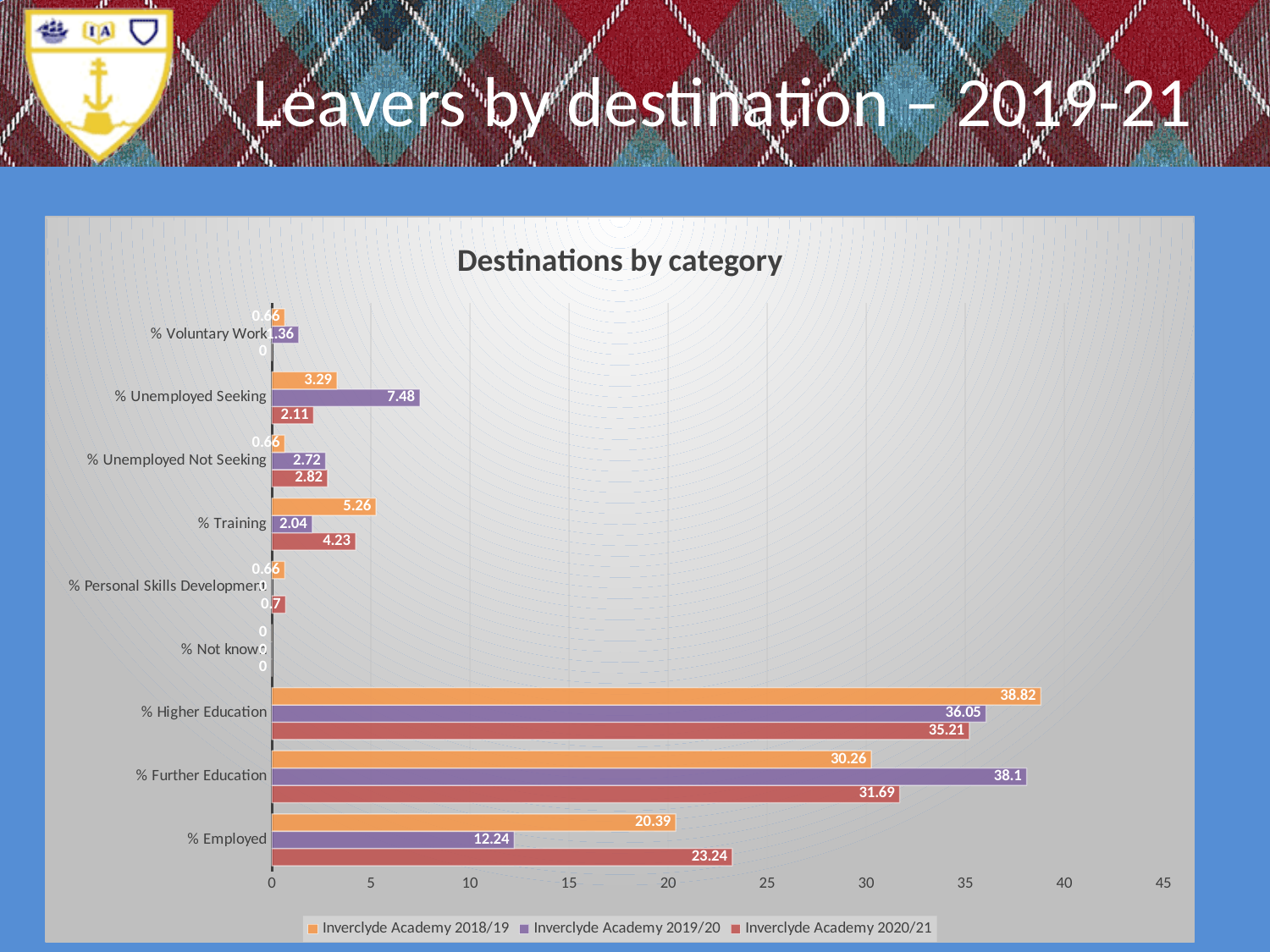
What is the value for % Employed for Inverclyde Academy 2020/21? 23.24 What is the value for % Higher Education for Inverclyde Academy 2018/19? 38.82 Which category has the highest value for Inverclyde Academy 2019/20? % Further Education What is the value for % Further Education for Inverclyde Academy 2019/20? 38.1 How many destination categories are shown on the chart? 9 What kind of chart is shown on the slide? bar chart Is the value for % Further Education for Inverclyde Academy 2018/19 greater or less than 25? greater What is the value for % Unemployed Seeking for Inverclyde Academy 2019/20? 7.48 What is the difference between the % Employed values for Inverclyde Academy 2020/21 and Inverclyde Academy 2019/20? 11 How many series does the legend list? 3 Which series has the lowest value for % Employed? Inverclyde Academy 2019/20 Which is larger for % Higher Education: Inverclyde Academy 2018/19 or Inverclyde Academy 2020/21? Inverclyde Academy 2018/19